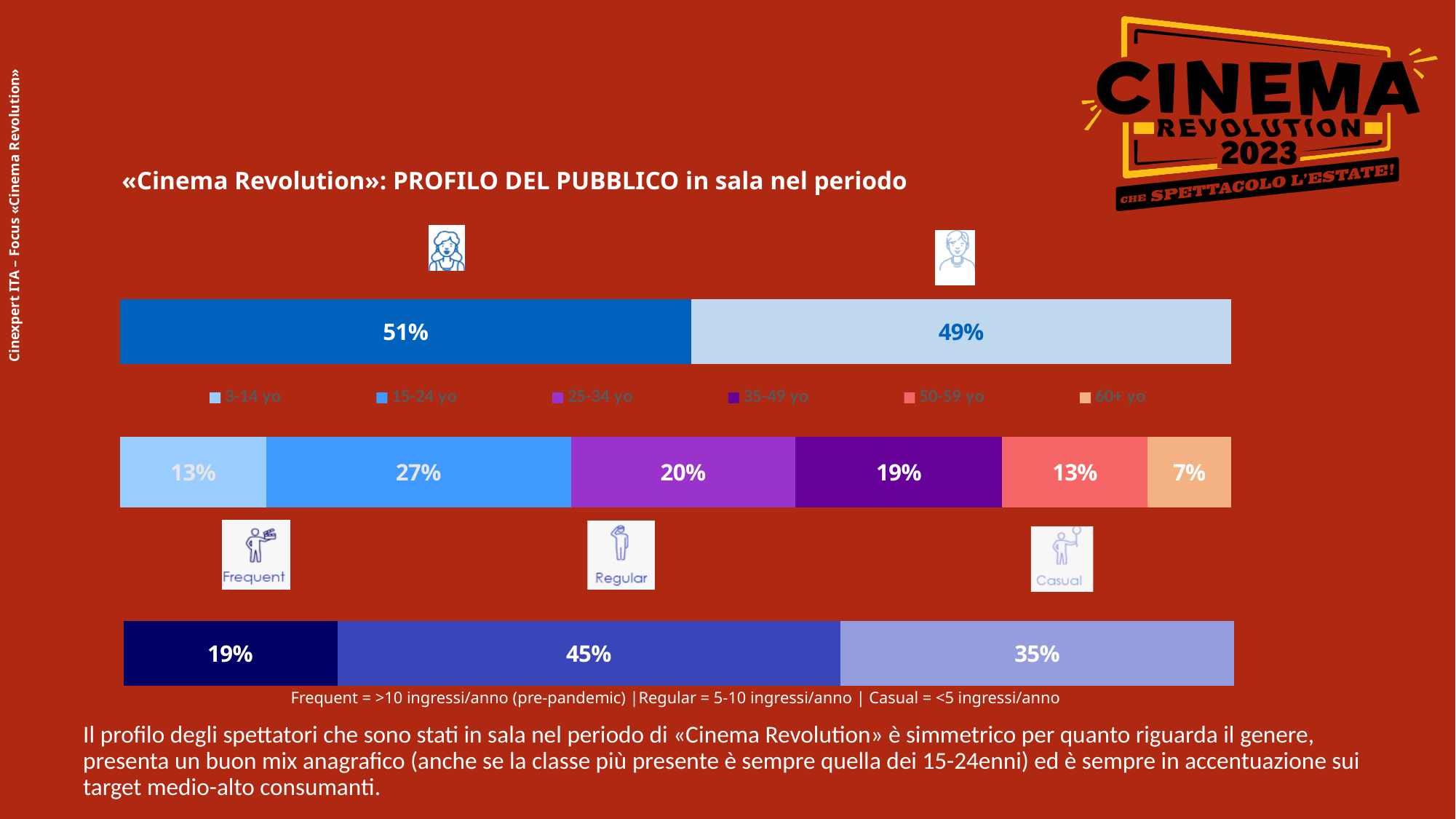
In the age-group chart (middle bar), what is the difference between the 25-34 yo and 35-49 yo values? 1% How many age groups does the legend of the middle bar chart list? 6 In the frequency chart (bottom bar), what is the value for Regular? 45% In the frequency chart (bottom bar), what is the value for Casual? 35% In the age-group chart (middle bar), which age group has the highest share? 15-24 yo In the top bar chart, what is the value of the left (dark blue) segment? 51% In the age-group chart (middle bar), what is the value for 60+ yo? 7% What kind of chart is used for the three bars on the slide? Stacked bar chart In the age-group chart (middle bar), what is the value for 15-24 yo? 27% In the age-group chart (middle bar), which age group has the lowest share? 60+ yo In the age-group chart (middle bar), which is larger: 15-24 yo or 25-34 yo? 15-24 yo In the frequency chart (bottom bar), what is the difference between Regular and Frequent? 26%